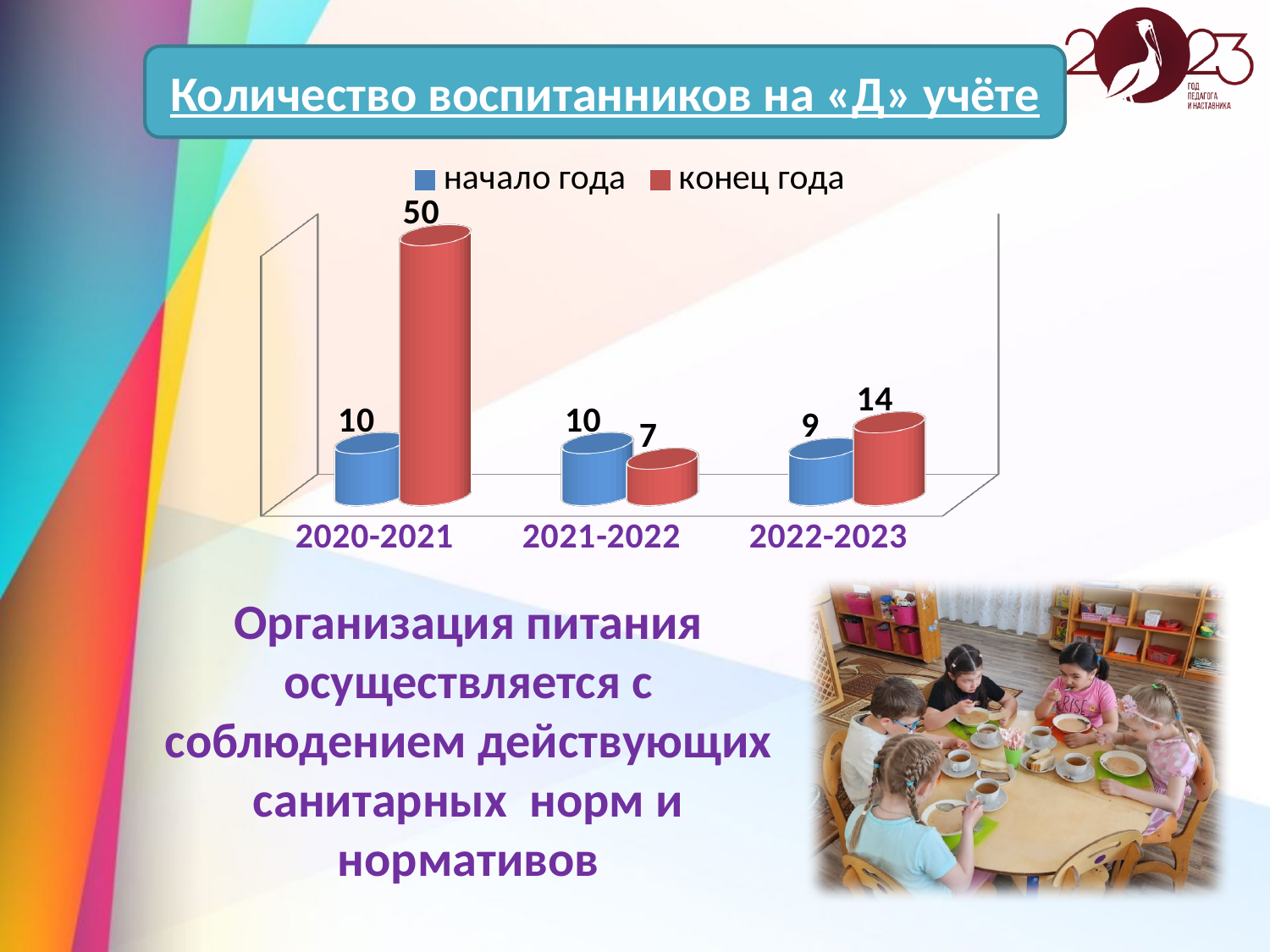
In 2021-2022, which is larger: "начало года" or "конец года"? начало года What is the value for "конец года" in 2020-2021? 50 What is the title of the chart? Количество воспитанников на «Д» учёте How many series does the legend list? 2 Which year has the highest "конец года" value? 2020-2021 What is the difference between "конец года" and "начало года" in 2020-2021? 40 Which year has the lowest "конец года" value? 2021-2022 What is the value for "конец года" in 2021-2022? 7 What is the value for "начало года" in 2022-2023? 9 What is the difference between "конец года" and "начало года" in 2022-2023? 5 What kind of chart is shown on the slide? bar chart How many year categories are shown on the x axis? 3